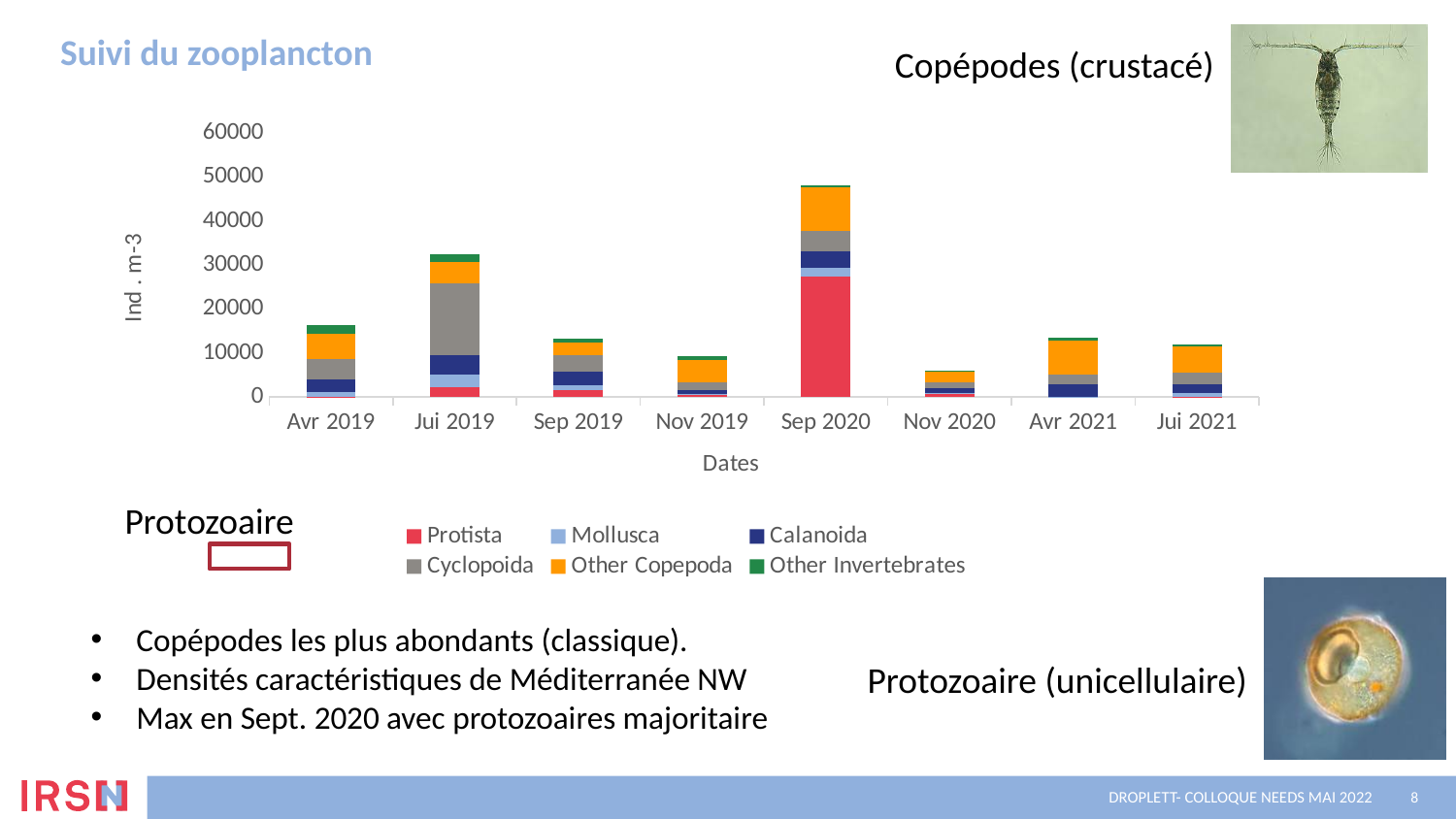
What is the title of the y axis of the chart? Ind . m-3 Which date has the lowest total bar in the chart? Nov 2020 Is the total value for Sep 2020 greater or less than 40000? greater What kind of chart is shown on the slide? Stacked bar chart Which has the larger total bar, Jui 2019 or Sep 2019? Jui 2019 Is the total value for Avr 2019 greater or less than 20000? less Which colour represents Protista in the chart legend? Red Is the total value for Jui 2019 greater or less than 20000? greater Which date has the highest total bar in the chart? Sep 2020 How many series does the chart legend list? 6 How many dates are shown on the x axis of the chart? 8